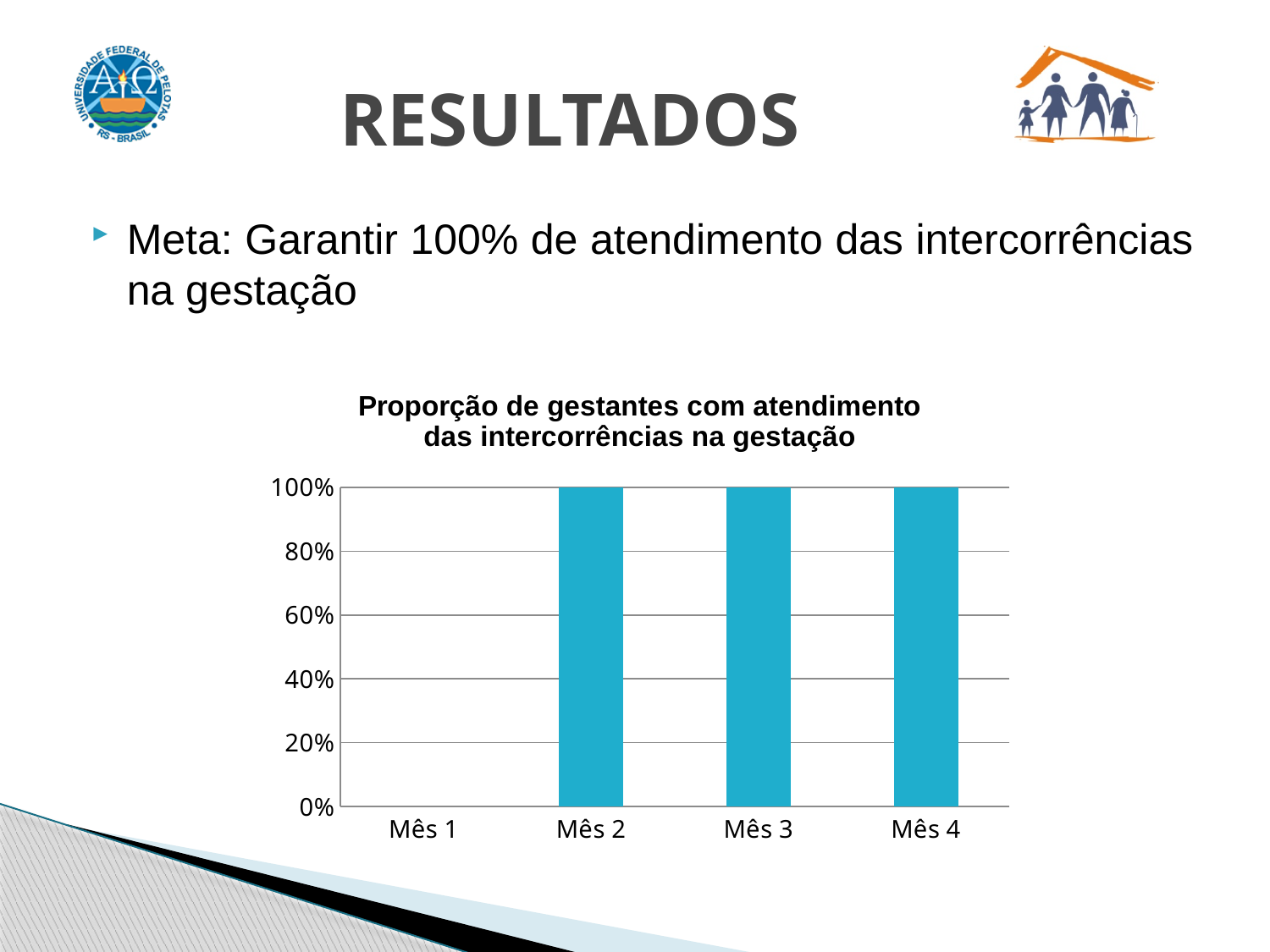
What is the value for Mês 4? 100% What is the title of the chart? Proporção de gestantes com atendimento das intercorrências na gestação What is the highest value shown on the y axis of the chart? 100% What is the difference between the value for Mês 2 and the value for Mês 1? 100% Which month has the lowest value? Mês 1 What is the value for Mês 1? 0% What kind of chart is shown on the slide? bar chart How many categories are shown on the x axis of the chart? 4 Which is larger, the value for Mês 1 or the value for Mês 3? Mês 3 Is the value for Mês 3 greater or less than 80%? greater Do the values rise or fall from Mês 1 to Mês 2? rise What is the value for Mês 2? 100%